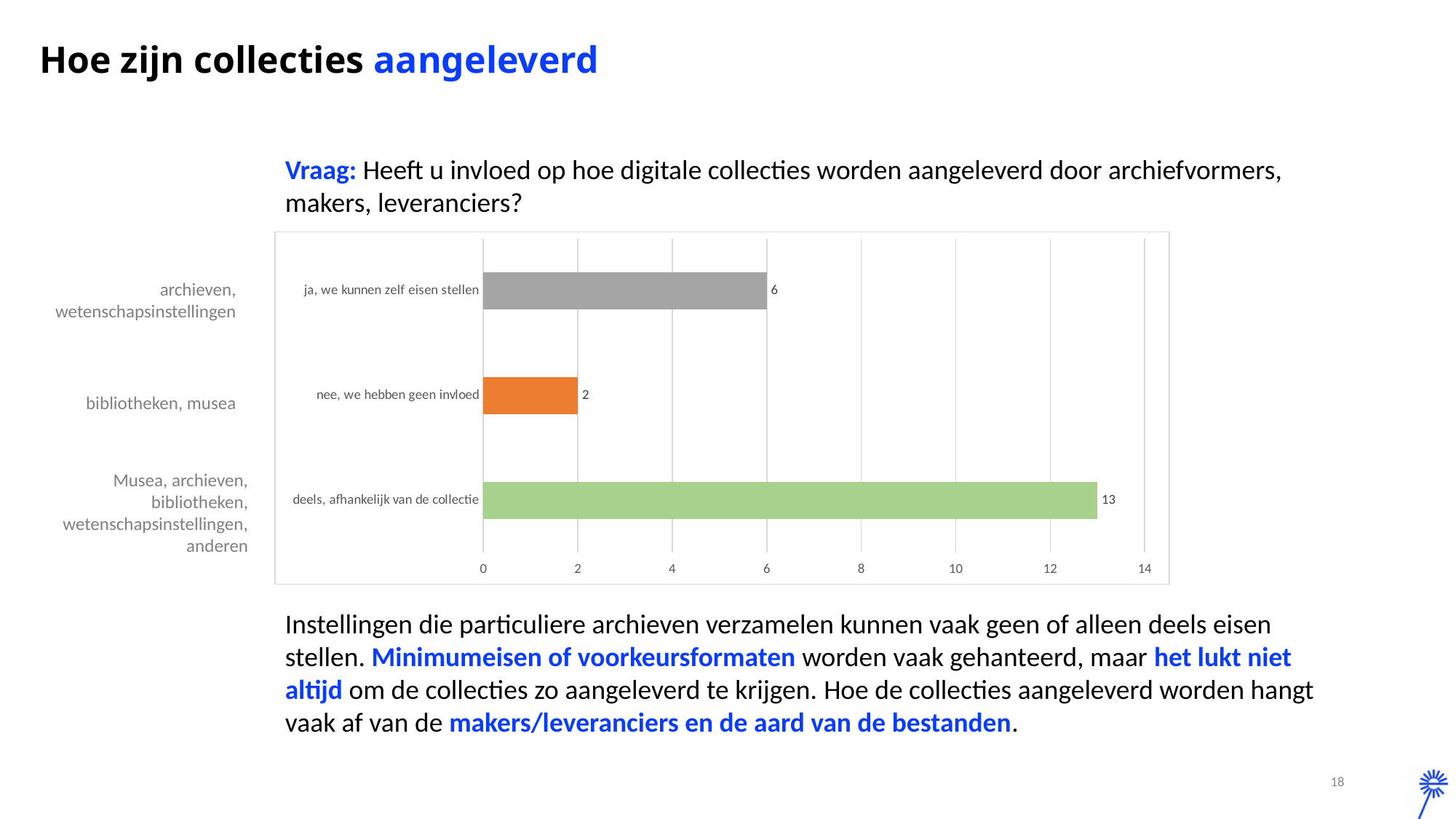
What is the difference between the values for "ja, we kunnen zelf eisen stellen" and "nee, we hebben geen invloed"? 4 What is the value for "ja, we kunnen zelf eisen stellen"? 6 What is the value for "deels, afhankelijk van de collectie"? 13 What colour is the bar for "deels, afhankelijk van de collectie"? green Which is larger: the value for "ja, we kunnen zelf eisen stellen" or for "nee, we hebben geen invloed"? ja, we kunnen zelf eisen stellen Which category has the lowest value? nee, we hebben geen invloed Which category has the highest value? deels, afhankelijk van de collectie What is the difference between the values for "deels, afhankelijk van de collectie" and "ja, we kunnen zelf eisen stellen"? 7 How many categories are shown in the chart? 3 What is the value for "nee, we hebben geen invloed"? 2 Is the value for "deels, afhankelijk van de collectie" greater or less than 10? greater What kind of chart is shown on the slide? bar chart